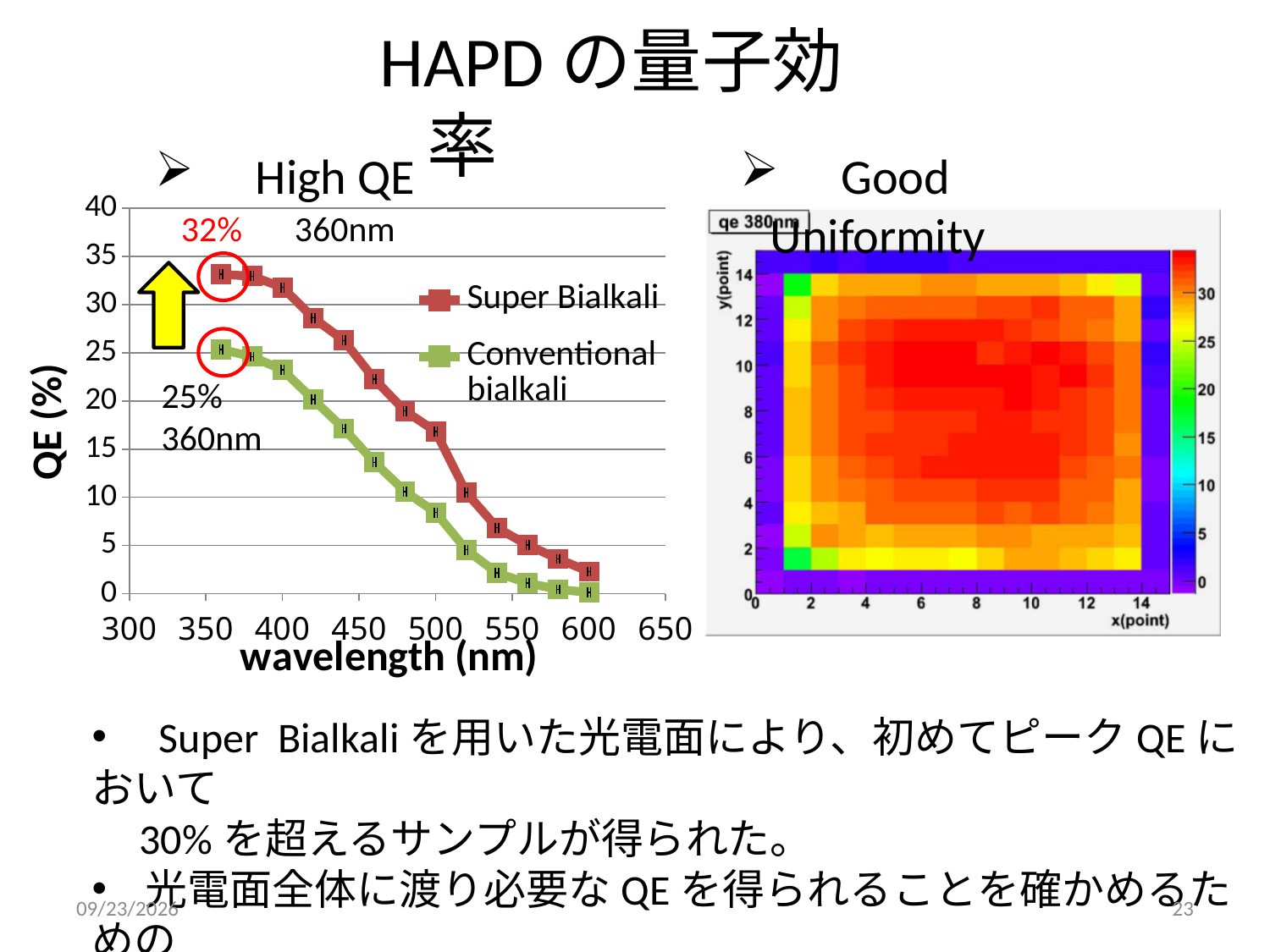
In the left chart, which series has the higher QE at 360nm, Super Bialkali or Conventional bialkali? Super Bialkali In the left chart, is the QE value for Super Bialkali at 600 nm greater or less than 5? less What kind of chart is the left chart showing QE versus wavelength? Line chart What is the label of the y axis of the left chart? QE (%) In the left chart, what is the QE value marked for Conventional bialkali at 360nm? 25% What is the title shown in the box at the top left of the right-hand heat map? qe 380nm In the left chart, what is the QE value marked for Super Bialkali at 360nm? 32% How many series does the legend of the left chart list? 2 In the left chart, do the QE values rise or fall as wavelength increases from 400 nm to 600 nm? Fall In the left chart, what is the difference between the marked QE values of Super Bialkali and Conventional bialkali at 360nm? 7% In the left chart, is the QE value for Super Bialkali at 500 nm greater or less than 15? greater In the left chart, is the QE value for Conventional bialkali at 500 nm greater or less than 10? less